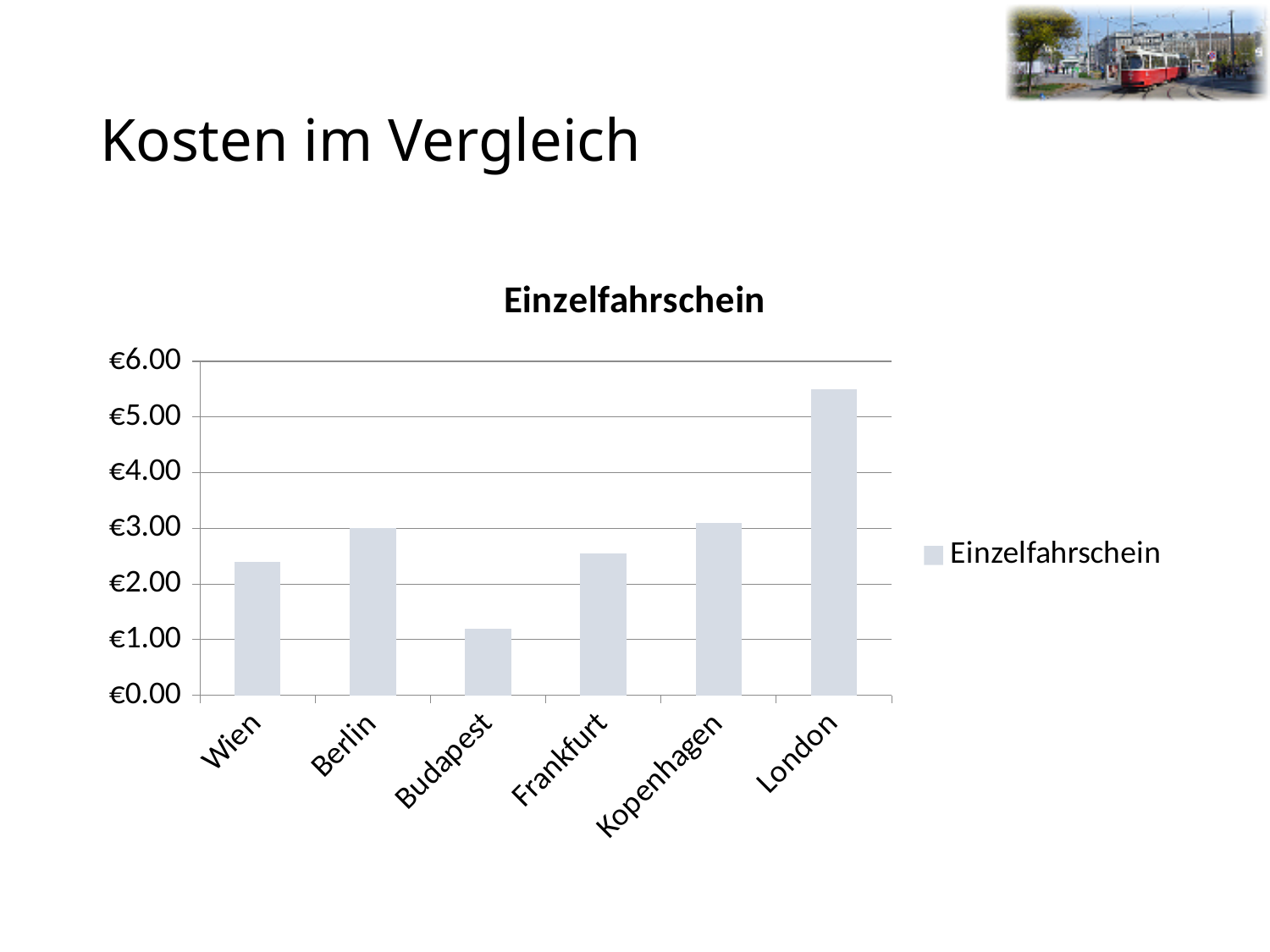
Which city has the lowest Einzelfahrschein price? Budapest What is the title of the chart? Einzelfahrschein Is the value for Budapest greater or less than €2.00? less Which has the higher value, Kopenhagen or Budapest? Kopenhagen Which city has the highest Einzelfahrschein price? London Is the value for Wien greater or less than €2.00? greater What type of chart is shown on the slide? bar chart Which has the higher value, London or Wien? London Is the value for London greater or less than €5.00? greater How many cities are shown on the x axis of the chart? 6 How many series does the legend list? 1